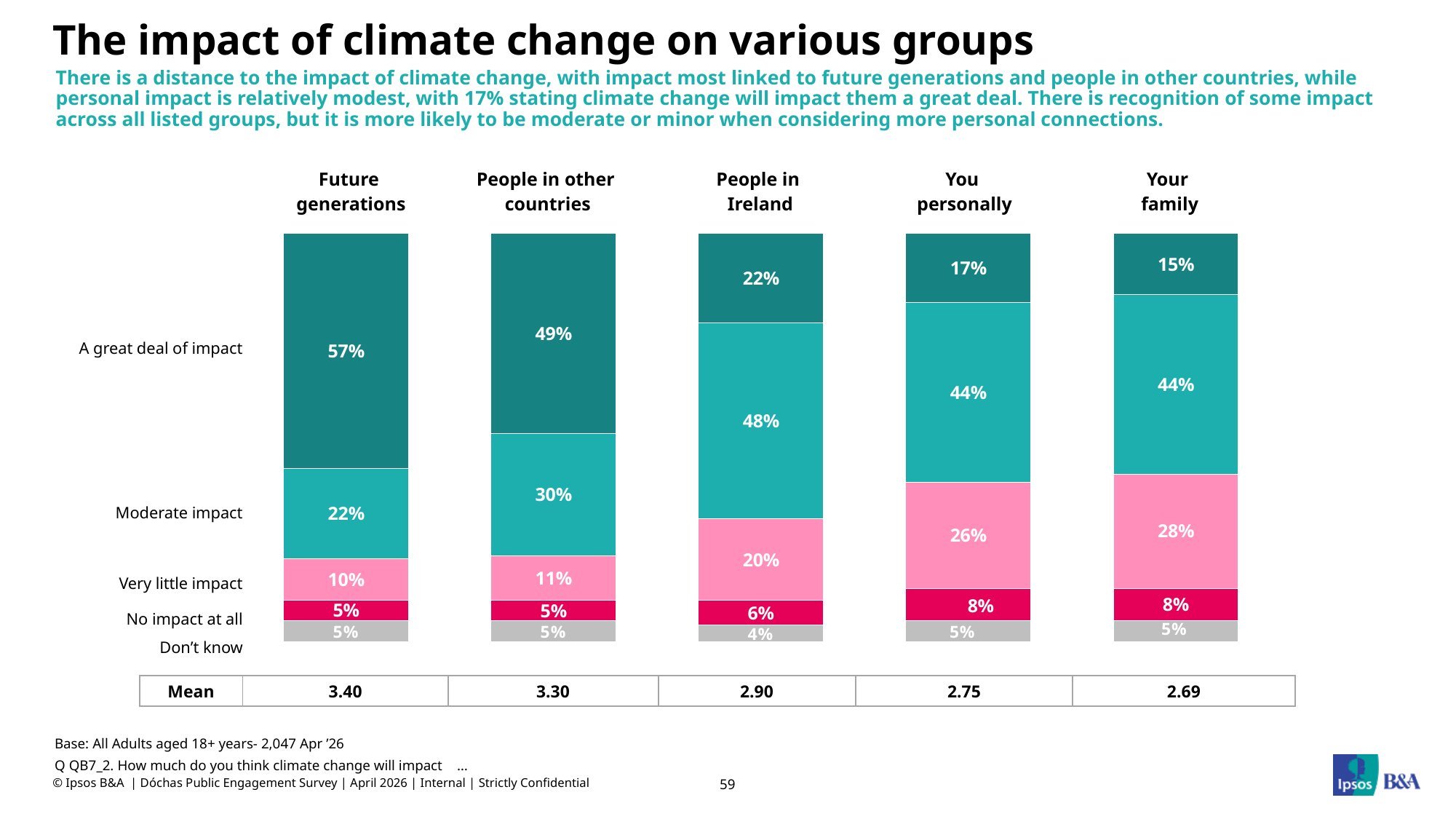
What is the mean score shown for People in Ireland? 2.90 What type of chart is shown on the slide? Stacked bar chart What is the total of all segments in the 'You personally' bar? 100% Which has the larger 'Very little impact' share: Your family or You personally? Your family What is the title of the slide? The impact of climate change on various groups Which group has the highest share saying 'A great deal of impact'? Future generations How many groups are shown as bars in the chart? 5 Which group has the lowest share saying 'A great deal of impact'? Your family How many response categories (segments) make up each stacked bar? 5 What is the difference in percentage points between 'A great deal of impact' for future generations and for you personally? 40 percentage points What percentage say climate change will have a great deal of impact on future generations? 57% What percentage say climate change will have a moderate impact on people in Ireland? 48%